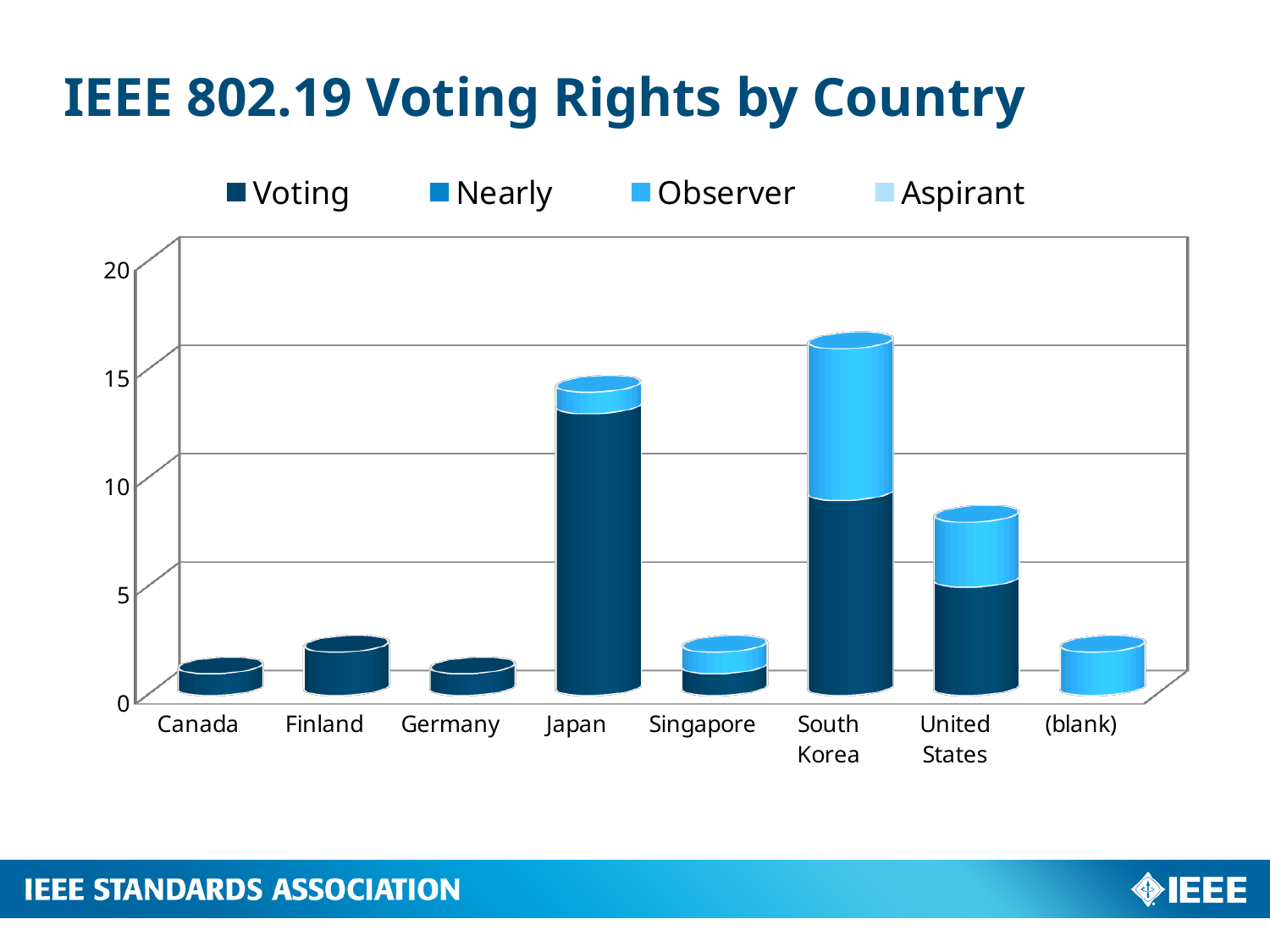
What is the title of the chart? IEEE 802.19 Voting Rights by Country Is the total bar height for Canada greater or less than 5? less Is the total bar height for United States greater or less than 10? less Is the total bar height for South Korea greater or less than 10? greater Which has the taller stacked bar, Japan or United States? Japan Which series is listed first in the legend? Voting Which has the taller stacked bar, South Korea or Finland? South Korea What kind of chart is shown on the slide? bar chart How many countries (categories) are shown on the x axis? 8 Which category has the tallest stacked bar? South Korea How many series does the legend list? 4